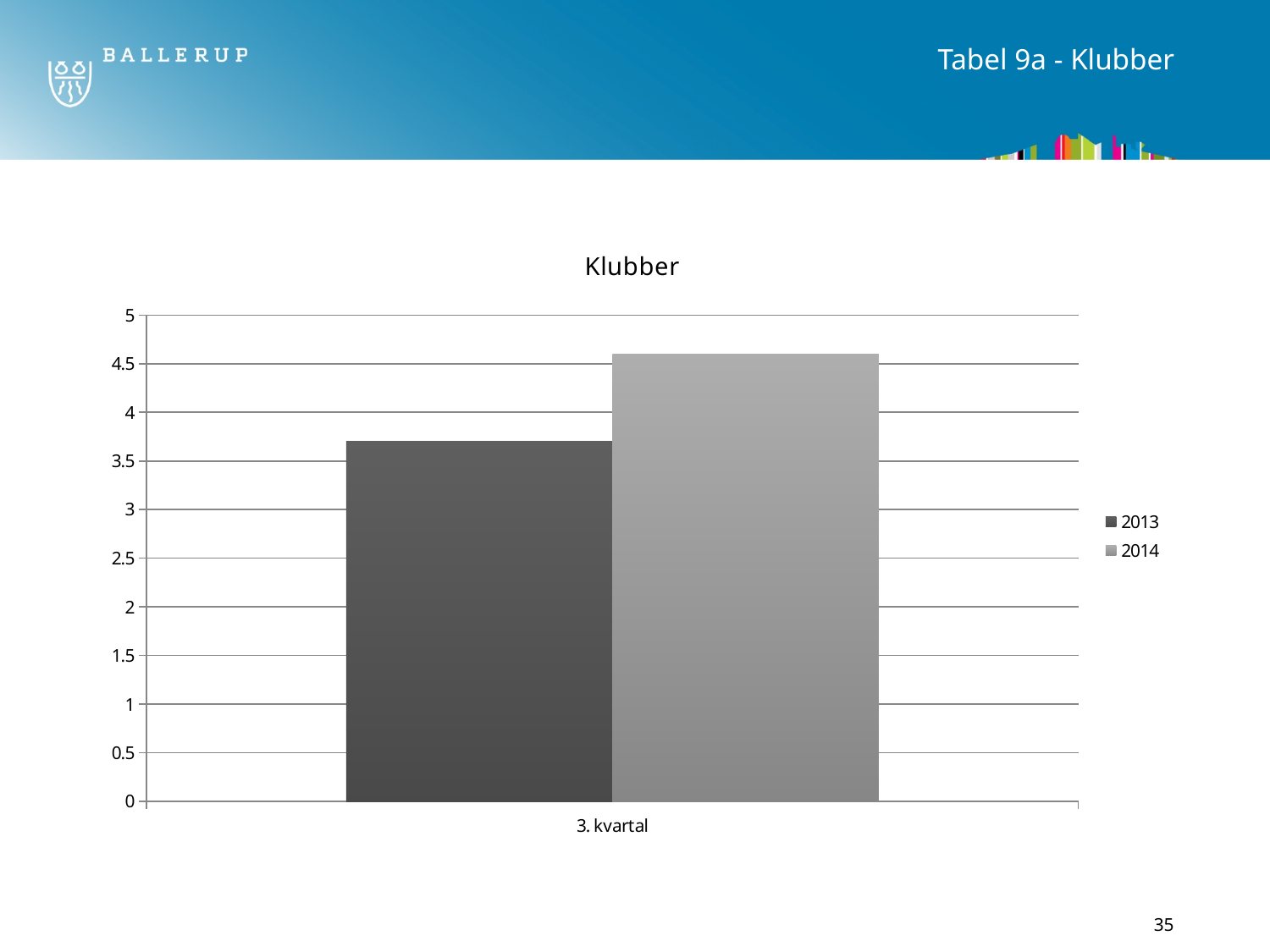
Which series has the lowest bar in the chart? 2013 Is the value for 2014 in 3. kvartal greater or less than 4? greater Is the value for 2013 in 3. kvartal greater or less than 4? less How many series does the legend list? 2 What is the category label on the x axis? 3. kvartal Is the value for 2014 in 3. kvartal greater or less than 5? less Which years are listed in the legend? 2013 and 2014 What kind of chart is shown on the slide? bar chart How many categories are shown on the x axis? 1 Which series has the higher value for 3. kvartal, 2013 or 2014? 2014 What is the title of the chart? Klubber